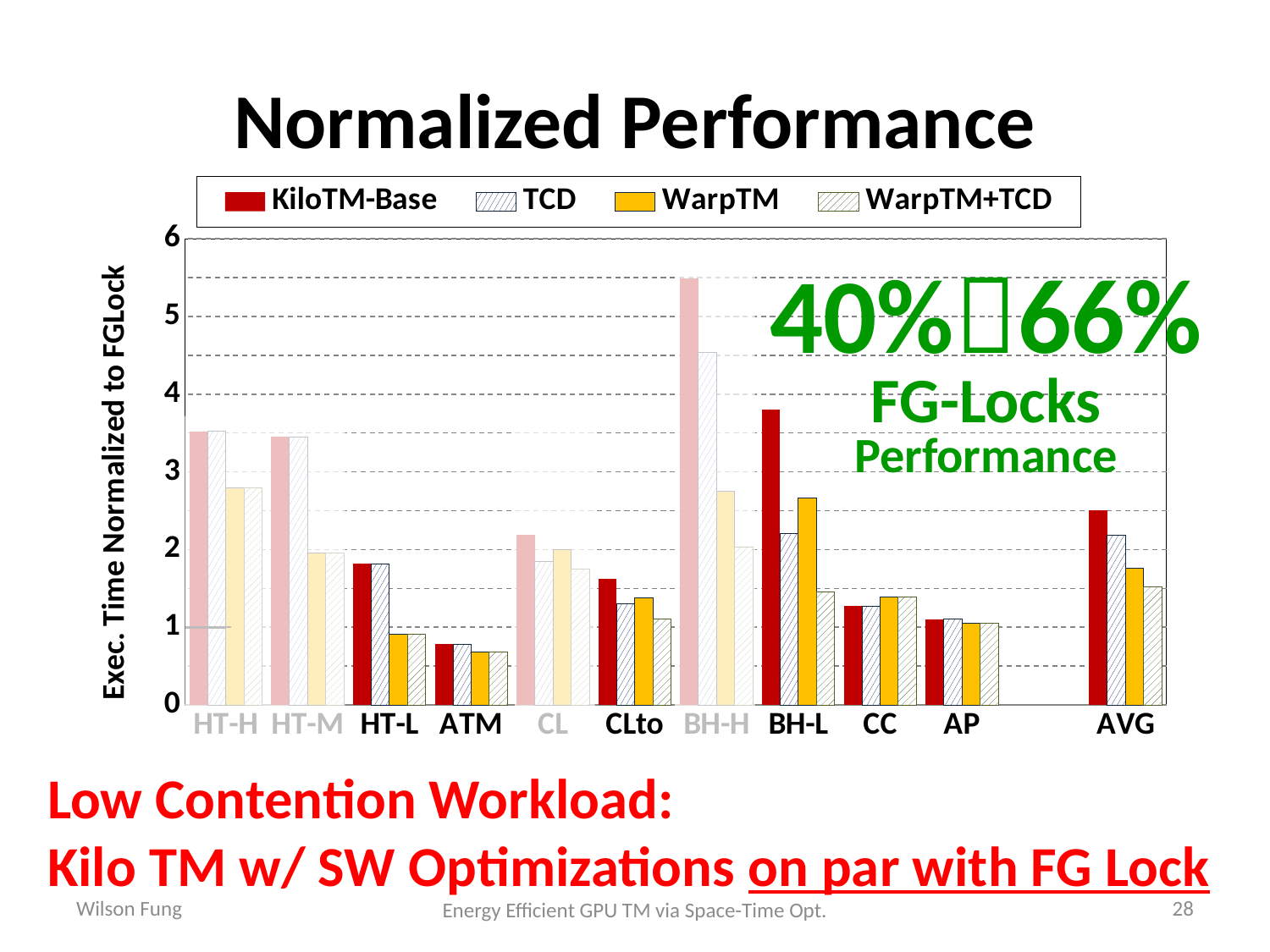
Which category has the highest KiloTM-Base bar? BH-H How many categories are shown along the x axis? 11 What is the label of the y axis? Exec. Time Normalized to FGLock Is the WarpTM value for HT-L greater or less than 1? less Is the KiloTM-Base value for HT-H greater or less than 3? greater Which is larger, the KiloTM-Base value for BH-L or the KiloTM-Base value for CC? BH-L Is the KiloTM-Base value for BH-H greater or less than 5? greater How many series does the legend list? 4 What is the title of the chart? Normalized Performance Which category has the lowest KiloTM-Base bar? ATM What kind of chart is shown on the slide? bar chart